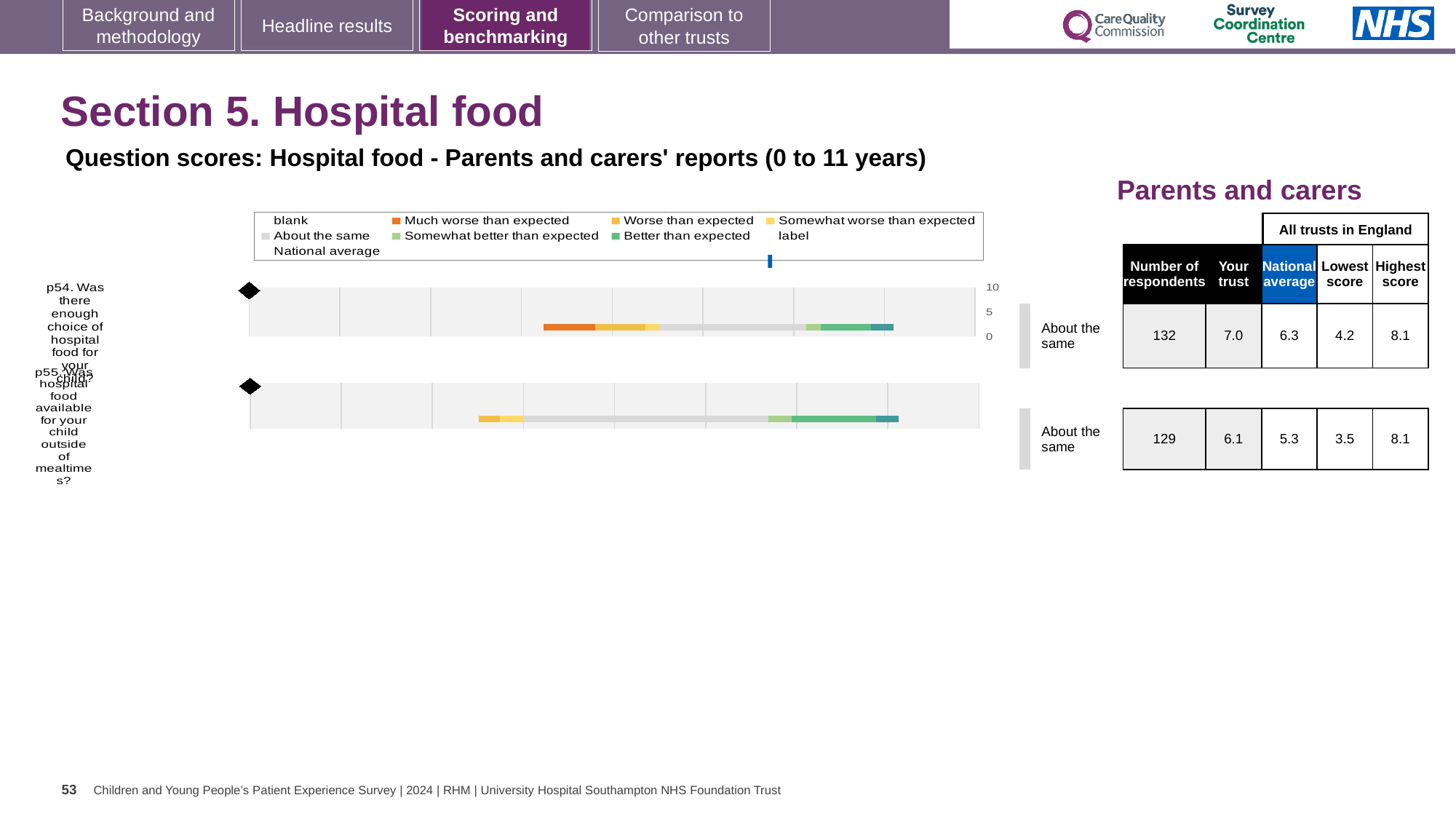
What benchmark category is shown next to the bar for p55 (hospital food available outside of mealtimes)? About the same What is the national average for p54 (enough choice of hospital food for your child)? 6.3 What is the 'Your trust' score for p55 (hospital food available outside of mealtimes)? 6.1 Which question has the higher 'Your trust' score, p54 or p55? p54 How many respondents answered p54? 132 How many questions (categories) are plotted in the chart? 2 What is the 'Your trust' score for p54 (enough choice of hospital food for your child)? 7.0 What is the highest value shown on the chart's axis? 10 Which colour in the legend represents 'Much worse than expected'? orange What is the difference between the 'Your trust' score and the national average for p55? 0.8 What kind of chart is shown on the slide? bar chart What benchmark category is shown next to the bar for p54 (enough choice of hospital food)? About the same